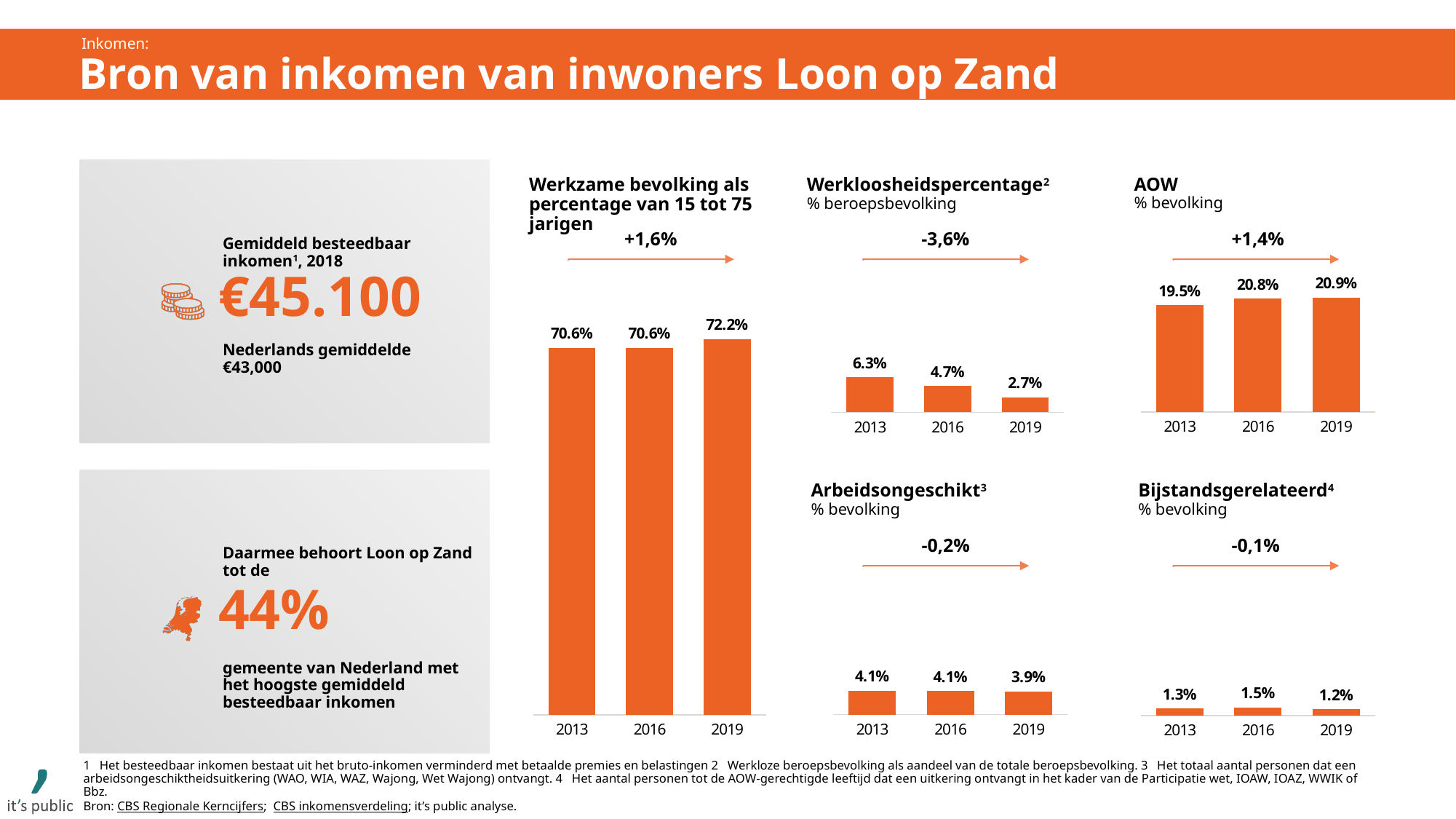
In the 'Werkloosheidspercentage' chart, which year has the lowest value? 2019 What kind of chart is the 'Werkloosheidspercentage' chart? bar chart In the 'Bijstandsgerelateerd' chart, which year has the highest value? 2016 In the 'Werkzame bevolking als percentage van 15 tot 75 jarigen' chart, what is the value for 2019? 72.2% In the 'AOW' chart, what is the value for 2016? 20.8% What change is shown above the arrow in the 'Werkzame bevolking als percentage van 15 tot 75 jarigen' chart? +1,6% In the 'Werkloosheidspercentage' chart, what is the value for 2013? 6.3% In the 'Werkloosheidspercentage' chart, what is the difference between the 2013 and 2019 values? 3.6% In the 'AOW' chart, what is the difference between the 2019 and 2013 values? 1.4% How many years are shown on the x axis of the 'AOW' chart? 3 In the 'Werkloosheidspercentage' chart, do the values rise or fall from 2013 to 2019? fall In the 'Arbeidsongeschikt' chart, is the value for 2016 larger or smaller than the value for 2019? larger